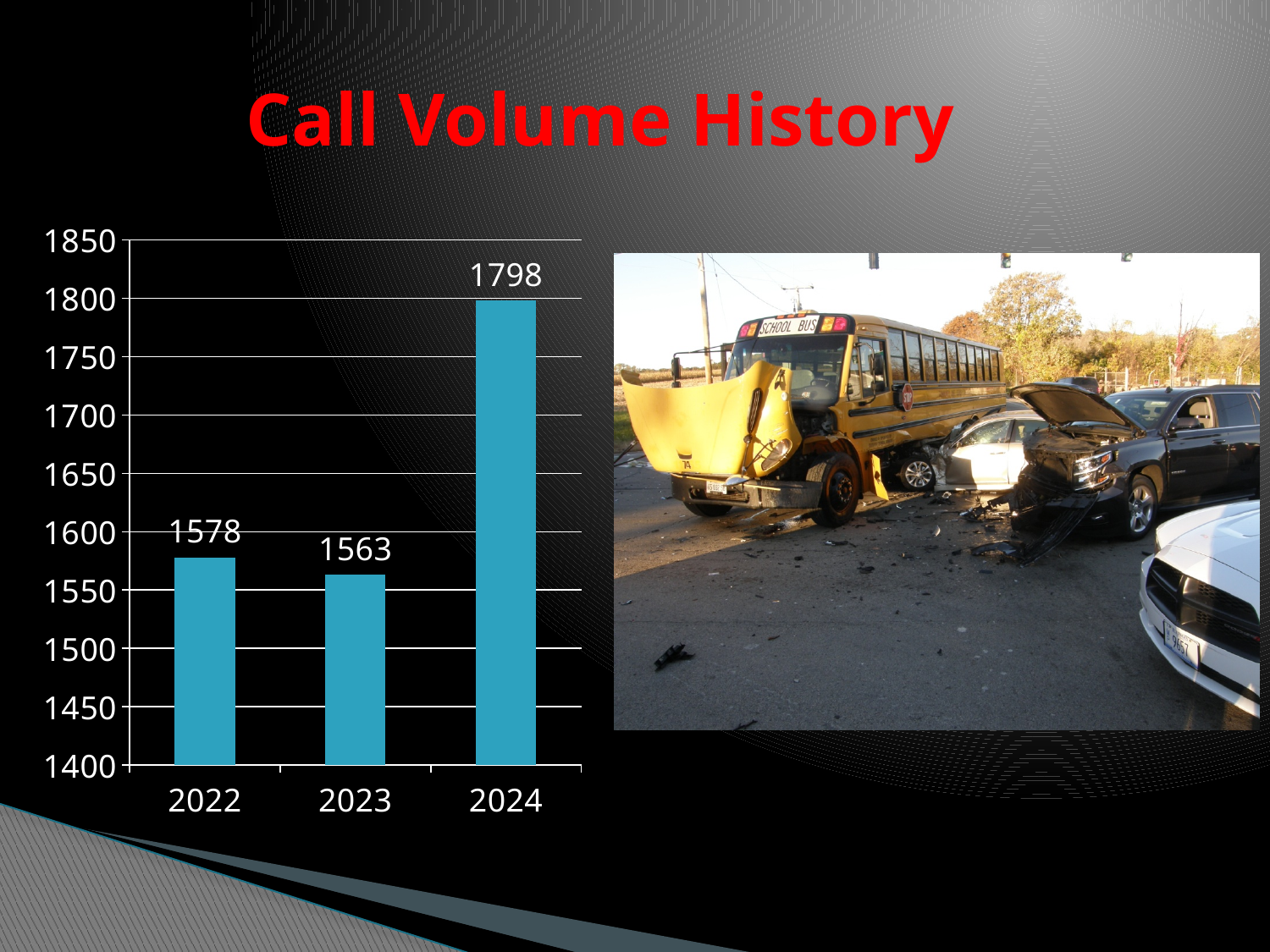
What is the difference in call volume between 2022 and 2023? 15 What is the difference in call volume between 2024 and 2023? 235 Which year has the highest call volume? 2024 What is the title of the slide containing the chart? Call Volume History What is the call volume for 2024? 1798 What is the call volume for 2023? 1563 How many years are shown on the chart? 3 Which year has a larger call volume, 2022 or 2024? 2024 Which year has the lowest call volume? 2023 Is the value for 2024 greater or less than 1750? greater What kind of chart is shown on the slide? bar chart What is the call volume for 2022? 1578